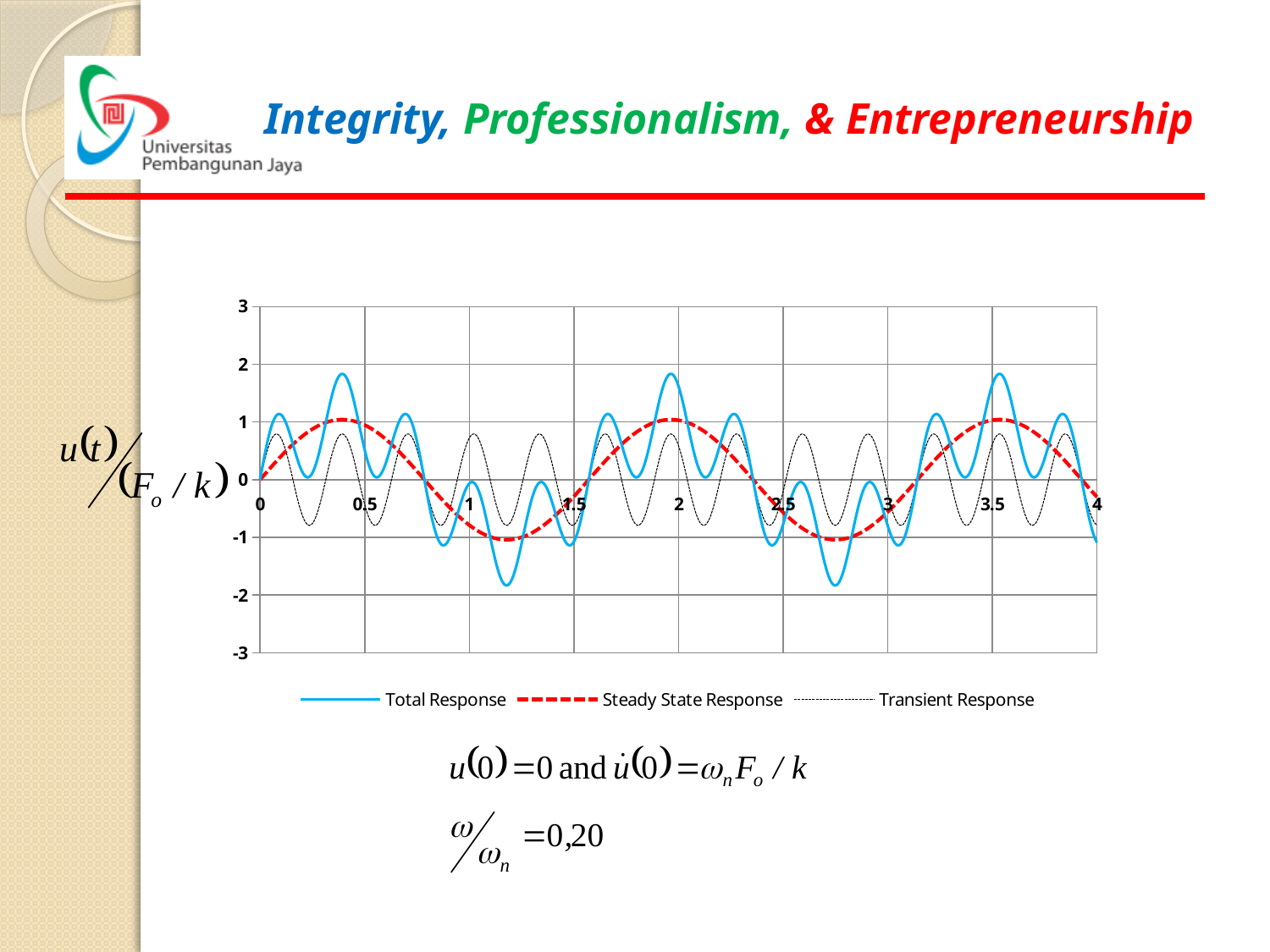
Which series is drawn with a solid blue line? Total Response How many series does the chart's legend list? 3 What is the largest value shown on the horizontal axis? 4 Which series is drawn with a red dashed line? Steady State Response Is the minimum value of the Total Response near x = 1.2 greater or less than -1? less Is the peak value of the Total Response near x = 0.4 greater or less than 1? greater How many tick labels are shown on the horizontal axis? 9 Which series reaches a higher peak value, Total Response or Steady State Response? Total Response What kind of chart is shown on the slide? line chart What is the highest value shown on the vertical axis? 3 Is the peak value of the Total Response near x = 0.4 greater or less than 2? less What is the lowest value shown on the vertical axis? -3